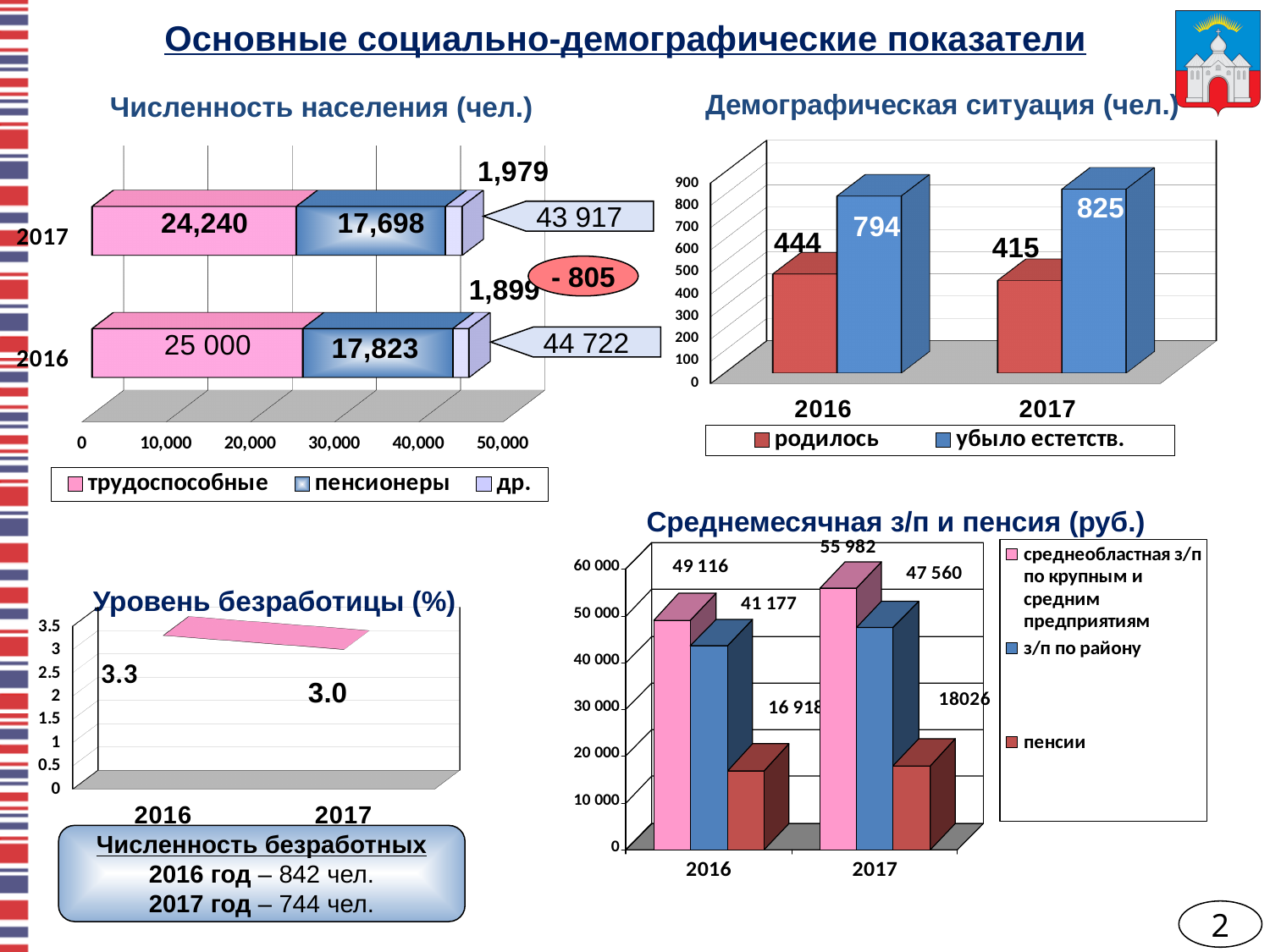
In the chart 'Численность населения (чел.)', what is the value for трудоспособные in 2017? 24,240 In the chart 'Демографическая ситуация (чел.)', what is the difference between убыло естеств. and родилось in 2016? 350 In the chart 'Численность населения (чел.)', what is the value for пенсионеры in 2016? 17,823 In the chart 'Демографическая ситуация (чел.)', which is larger in 2017: родилось or убыло естеств.? убыло естеств. In the chart 'Уровень безработицы (%)', do the values rise or fall from 2016 to 2017? fall In the chart 'Среднемесячная з/п и пенсия (руб.)', which series has the highest value in 2017? среднеобластная з/п по крупным и средним предприятиям In the chart 'Среднемесячная з/п и пенсия (руб.)', what is the value for з/п по району in 2016? 41 177 In the chart 'Численность населения (чел.)', how many series does the legend list? 3 In the chart 'Численность населения (чел.)', what is the total of the stacked bar for 2017? 43 917 In the chart 'Уровень безработицы (%)', what is the value for 2017? 3.0 In the chart 'Демографическая ситуация (чел.)', what is the value for убыло естеств. in 2017? 825 What kind of chart is 'Демографическая ситуация (чел.)'? bar chart